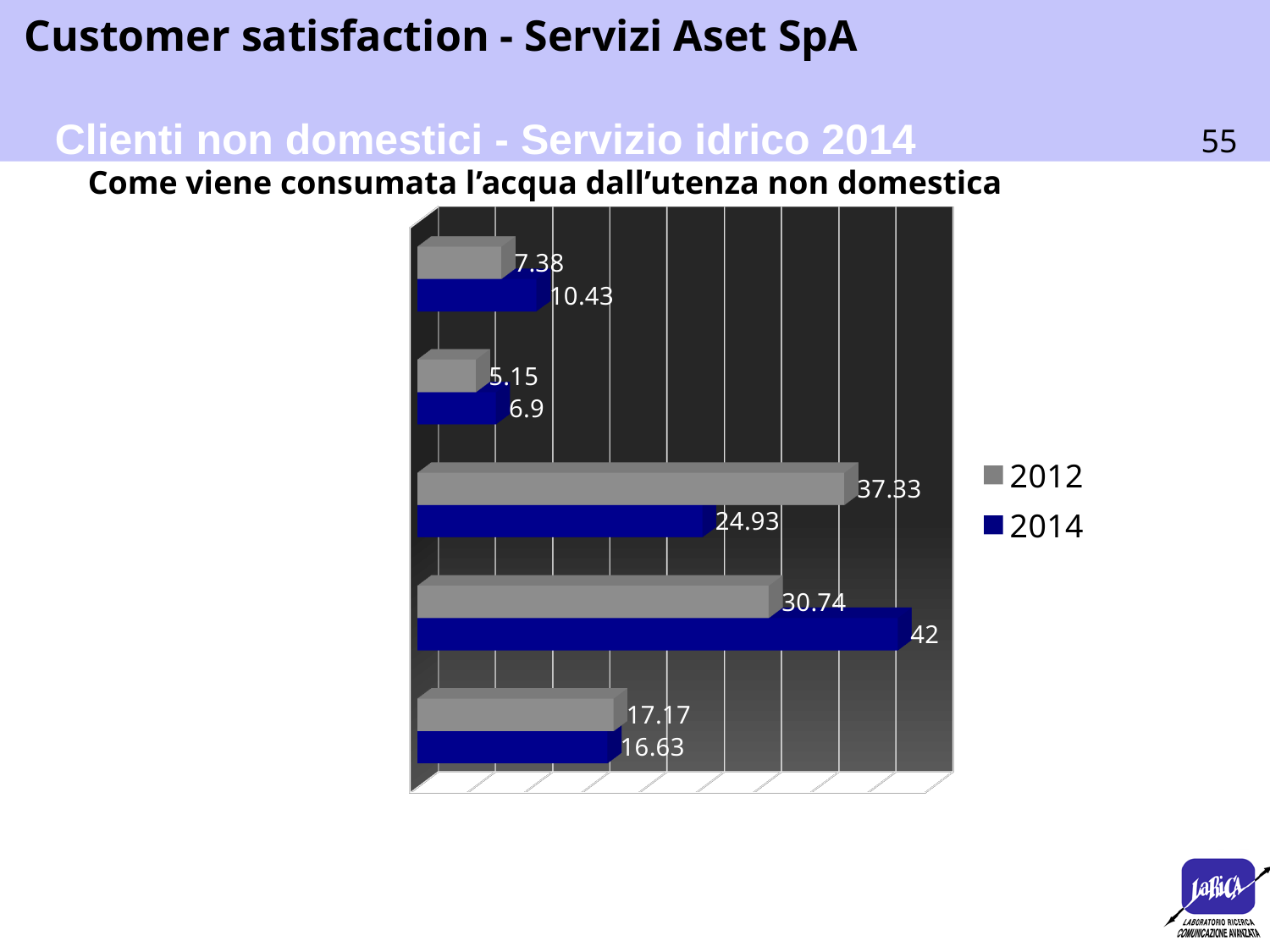
What is the 2012 value for the bottom group of bars? 17.17 What is the lowest value in the 2014 series? 6.9 In the middle (third) group of bars, which series has the larger value, 2012 or 2014? 2012 How many categories (groups of bars) are plotted in the chart? 5 What is the highest value in the 2012 series? 37.33 Which colour represents the 2014 series in the legend? dark blue What is the highest value in the 2014 series? 42 What is the difference between the 2014 value (42) and the 2012 value (30.74) in the fourth group of bars from the top? 11.26 How many series does the legend list? 2 What is the lowest value in the 2012 series? 5.15 What kind of chart is shown on the slide? bar chart What is the 2014 value for the topmost group of bars? 10.43